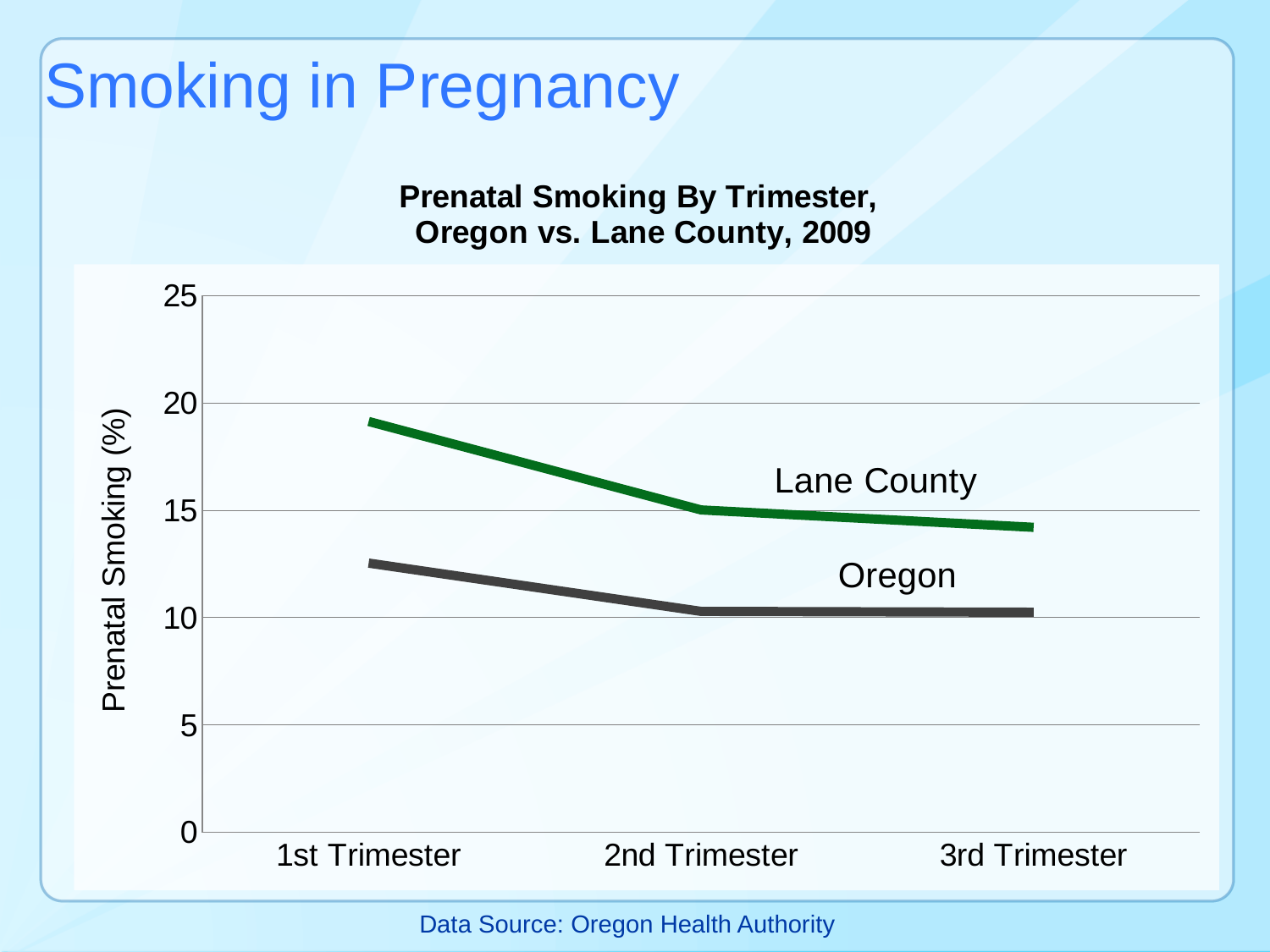
Does the Oregon line rise or fall from the 1st Trimester to the 2nd Trimester? Fall Which two series are plotted on the chart? Lane County and Oregon Is the Oregon value for the 1st Trimester greater or less than 15? less Is the Lane County value for the 1st Trimester greater or less than 15? greater In which trimester is the Lane County prenatal smoking rate highest? 1st Trimester Does the Lane County line rise or fall from the 1st Trimester to the 3rd Trimester? Fall In which trimester is the Oregon prenatal smoking rate highest? 1st Trimester What type of chart is shown on the slide? Line chart What is the title of the chart? Prenatal Smoking By Trimester, Oregon vs. Lane County, 2009 In the 2nd Trimester, which is larger: the Lane County value or the Oregon value? Lane County How many trimesters are shown along the x axis of the chart? 3 How many data series (lines) are plotted on the chart? 2